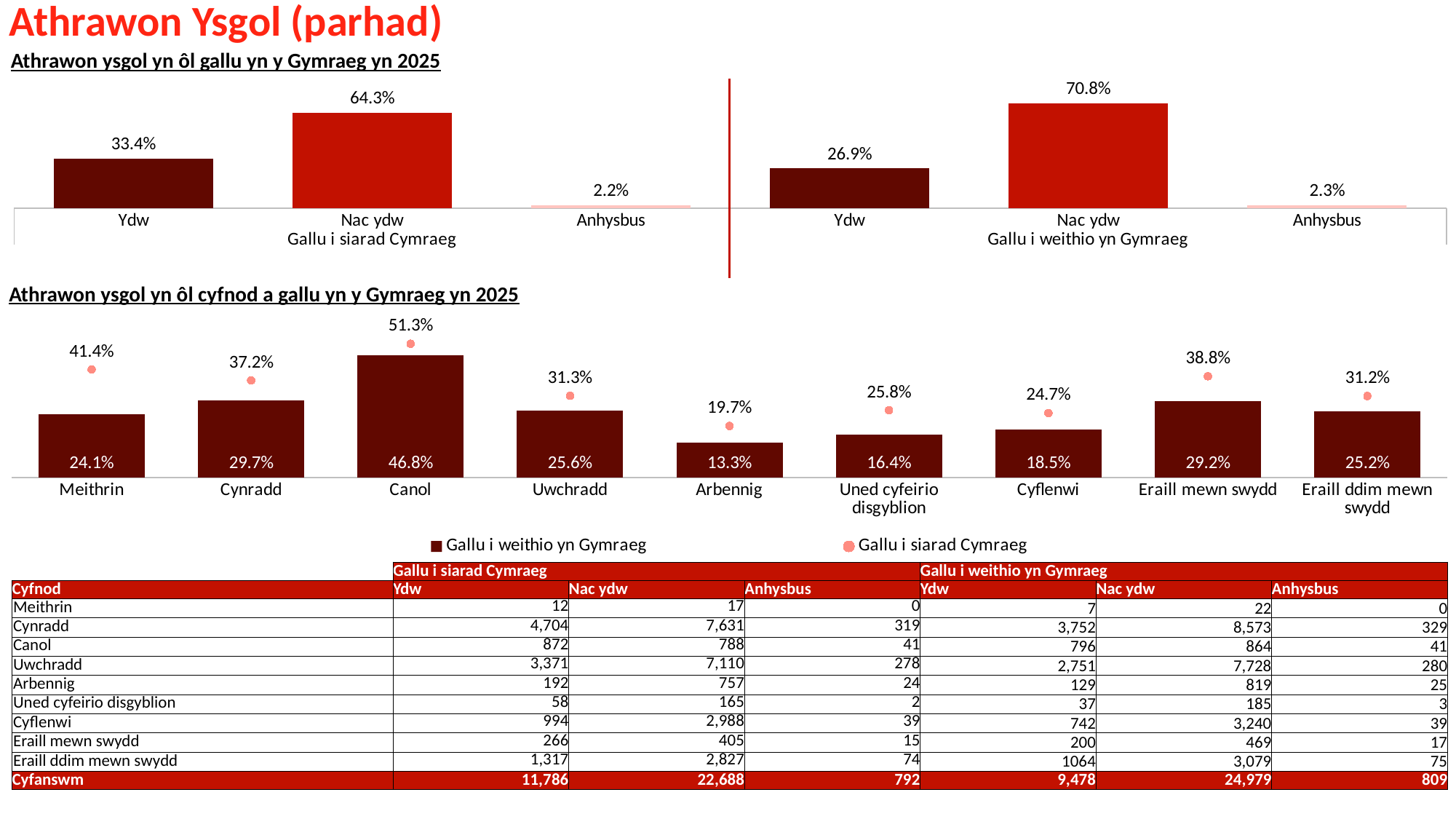
In the top chart 'Athrawon ysgol yn ôl gallu yn y Gymraeg yn 2025', what is the value for 'Nac ydw' under 'Gallu i siarad Cymraeg'? 64.3% How many categories are shown on the x axis of the bottom chart 'Athrawon ysgol yn ôl cyfnod a gallu yn y Gymraeg yn 2025'? 9 In the bottom chart 'Athrawon ysgol yn ôl cyfnod a gallu yn y Gymraeg yn 2025', what is the 'Gallu i siarad Cymraeg' value for 'Canol'? 51.3% In the bottom chart 'Athrawon ysgol yn ôl cyfnod a gallu yn y Gymraeg yn 2025', what is the 'Gallu i weithio yn Gymraeg' value for 'Arbennig'? 13.3% In the bottom chart 'Athrawon ysgol yn ôl cyfnod a gallu yn y Gymraeg yn 2025', what is the difference between the 'Gallu i siarad Cymraeg' and 'Gallu i weithio yn Gymraeg' values for 'Meithrin'? 17.3% How many series does the legend of the bottom chart 'Athrawon ysgol yn ôl cyfnod a gallu yn y Gymraeg yn 2025' list? 2 In the bottom chart 'Athrawon ysgol yn ôl cyfnod a gallu yn y Gymraeg yn 2025', which category has the lowest 'Gallu i siarad Cymraeg' value? Arbennig In the bottom chart 'Athrawon ysgol yn ôl cyfnod a gallu yn y Gymraeg yn 2025', which category has the highest 'Gallu i weithio yn Gymraeg' value? Canol In the top chart 'Athrawon ysgol yn ôl gallu yn y Gymraeg yn 2025', what is the value for 'Ydw' under 'Gallu i weithio yn Gymraeg'? 26.9% In the top chart 'Athrawon ysgol yn ôl gallu yn y Gymraeg yn 2025', which is larger: 'Ydw' for 'Gallu i siarad Cymraeg' or 'Ydw' for 'Gallu i weithio yn Gymraeg'? Ydw for Gallu i siarad Cymraeg In the top chart 'Athrawon ysgol yn ôl gallu yn y Gymraeg yn 2025', which category has the lowest value under 'Gallu i siarad Cymraeg'? Anhysbus In the top chart 'Athrawon ysgol yn ôl gallu yn y Gymraeg yn 2025', what is the difference between 'Nac ydw' and 'Ydw' under 'Gallu i weithio yn Gymraeg'? 43.9%